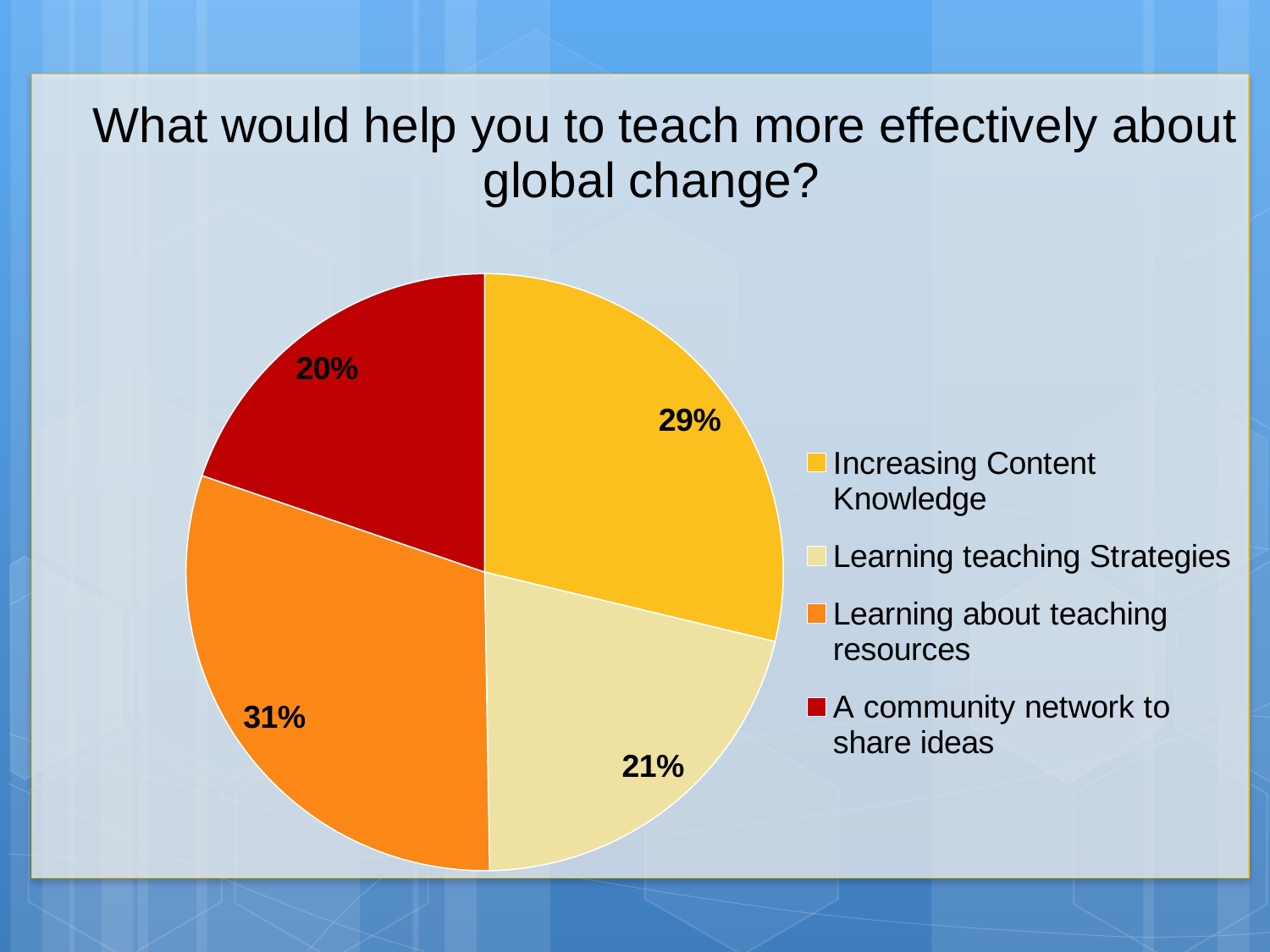
What is the difference in percentage points between 'Learning about teaching resources' and 'A community network to share ideas'? 11 What colour is the slice for 'A community network to share ideas'? red What share of the pie is 'Increasing Content Knowledge'? 29% What is the title of the slide containing the chart? What would help you to teach more effectively about global change? What share of the pie is 'Learning teaching Strategies'? 21% Which is larger: 'Increasing Content Knowledge' or 'Learning teaching Strategies'? Increasing Content Knowledge What share of the pie is 'Learning about teaching resources'? 31% What kind of chart is shown on the slide? pie chart Which category has the largest slice of the pie? Learning about teaching resources Which category has the smallest slice of the pie? A community network to share ideas How many categories does the pie chart have? 4